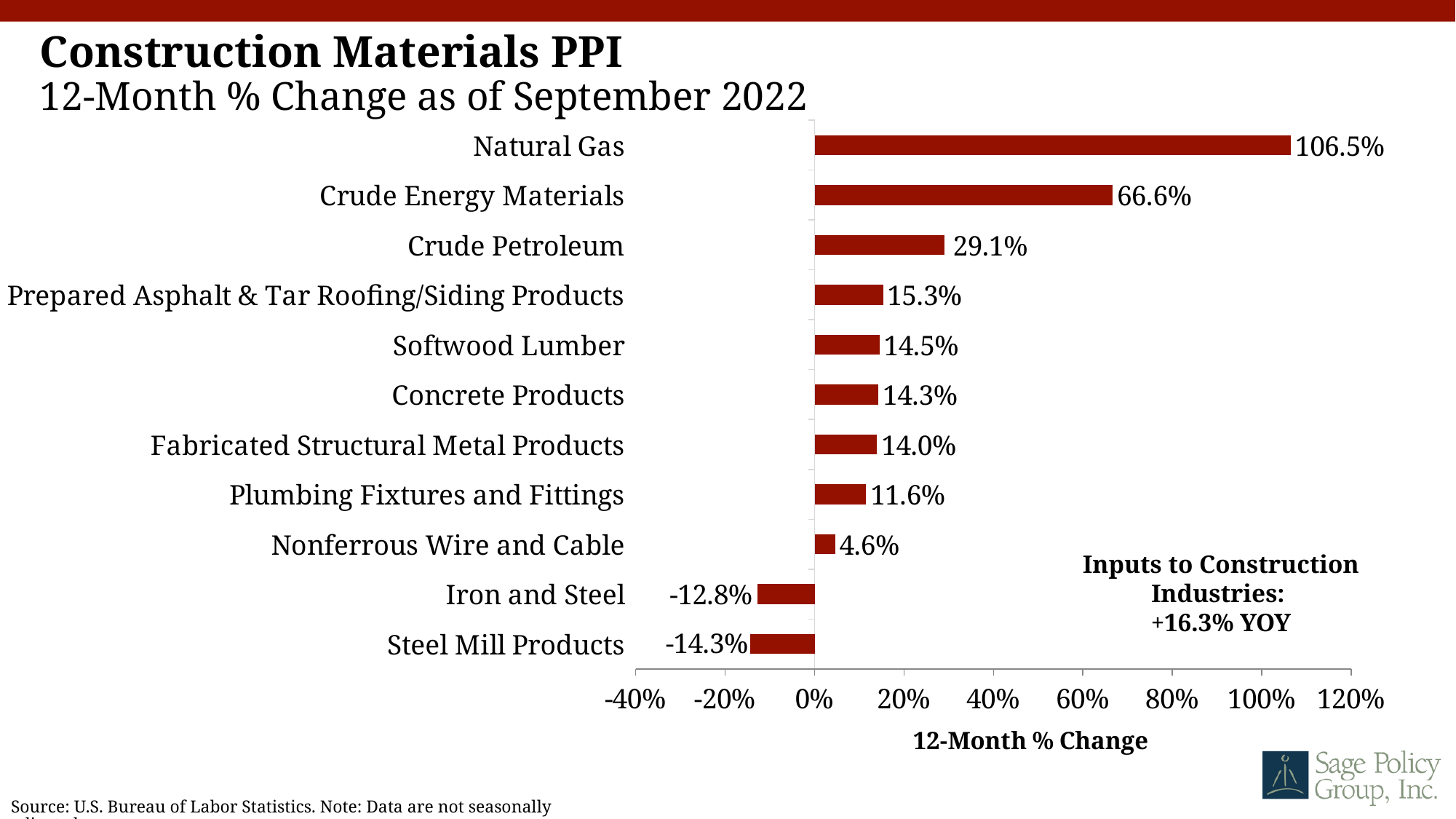
Which category has the highest 12-month % change? Natural Gas Which category has the lowest 12-month % change? Steel Mill Products Is the value for Crude Energy Materials greater or less than 60%? greater What is the 12-month % change for Softwood Lumber? 14.5% What is the 12-month % change for Natural Gas? 106.5% What is the 12-month % change for Steel Mill Products? -14.3% What year-over-year change is given for Inputs to Construction Industries in the annotation? +16.3% YOY Which has a larger 12-month % change, Crude Petroleum or Plumbing Fixtures and Fittings? Crude Petroleum How many categories are shown in the chart? 11 What kind of chart is shown on the slide? Bar chart What is the label of the horizontal axis? 12-Month % Change What is the difference between the 12-month % change for Natural Gas and Crude Energy Materials? 39.9%